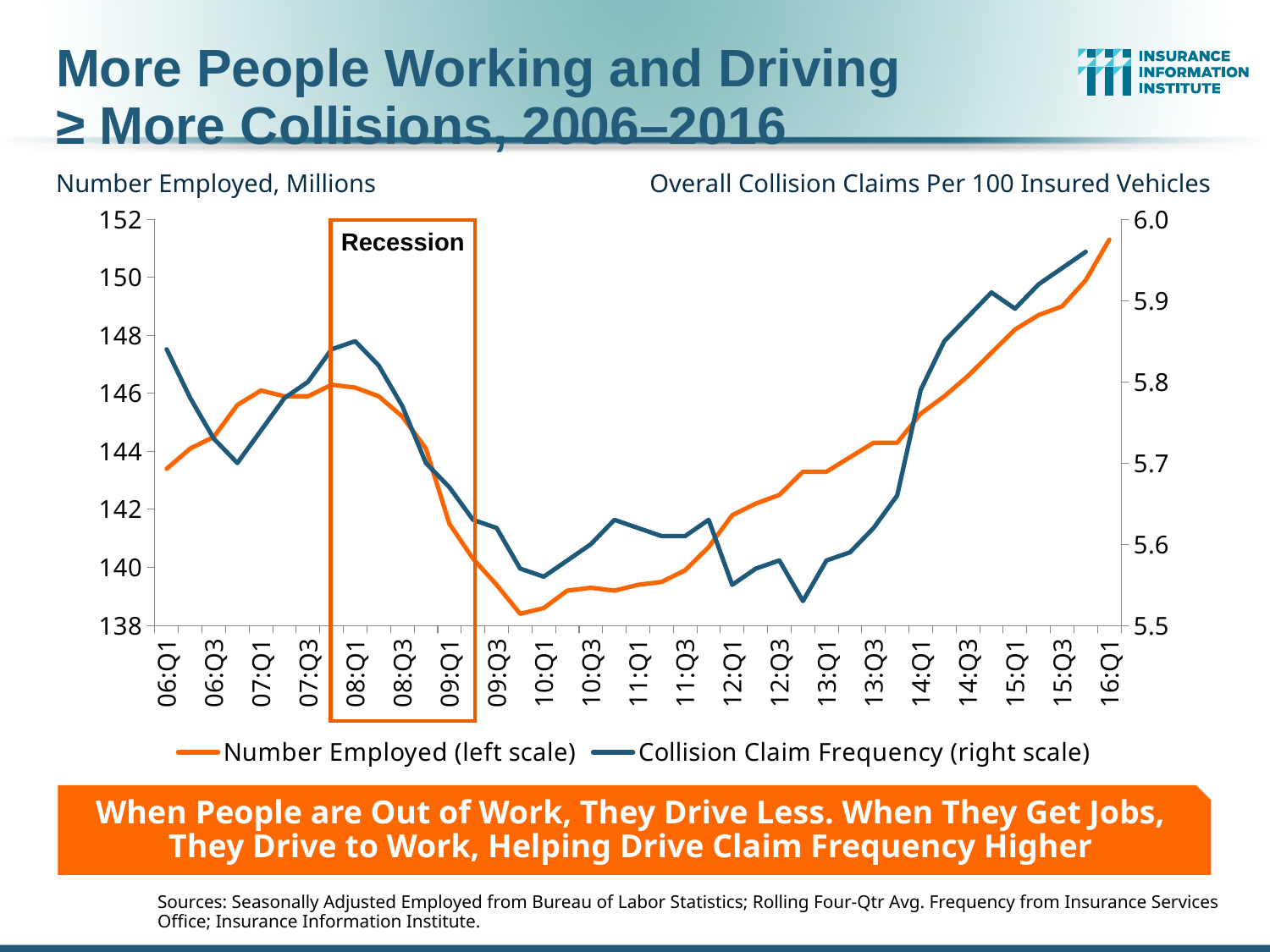
Is the value for Number Employed at 06:Q1 greater or less than 144? less Is the value for Collision Claim Frequency at 08:Q1 greater or less than 5.8? greater Is the value for Number Employed at 16:Q1 greater or less than 150? greater What label is shown in the highlighted box on the chart? Recession Does Number Employed rise or fall from 12:Q1 to 16:Q1? rise At which quarter is Number Employed highest? 16:Q1 What kind of chart is shown on the slide? Line chart At which quarter is Collision Claim Frequency highest? 15:Q4 How many series does the legend list? 2 Which series is plotted on the right scale according to the legend? Collision Claim Frequency